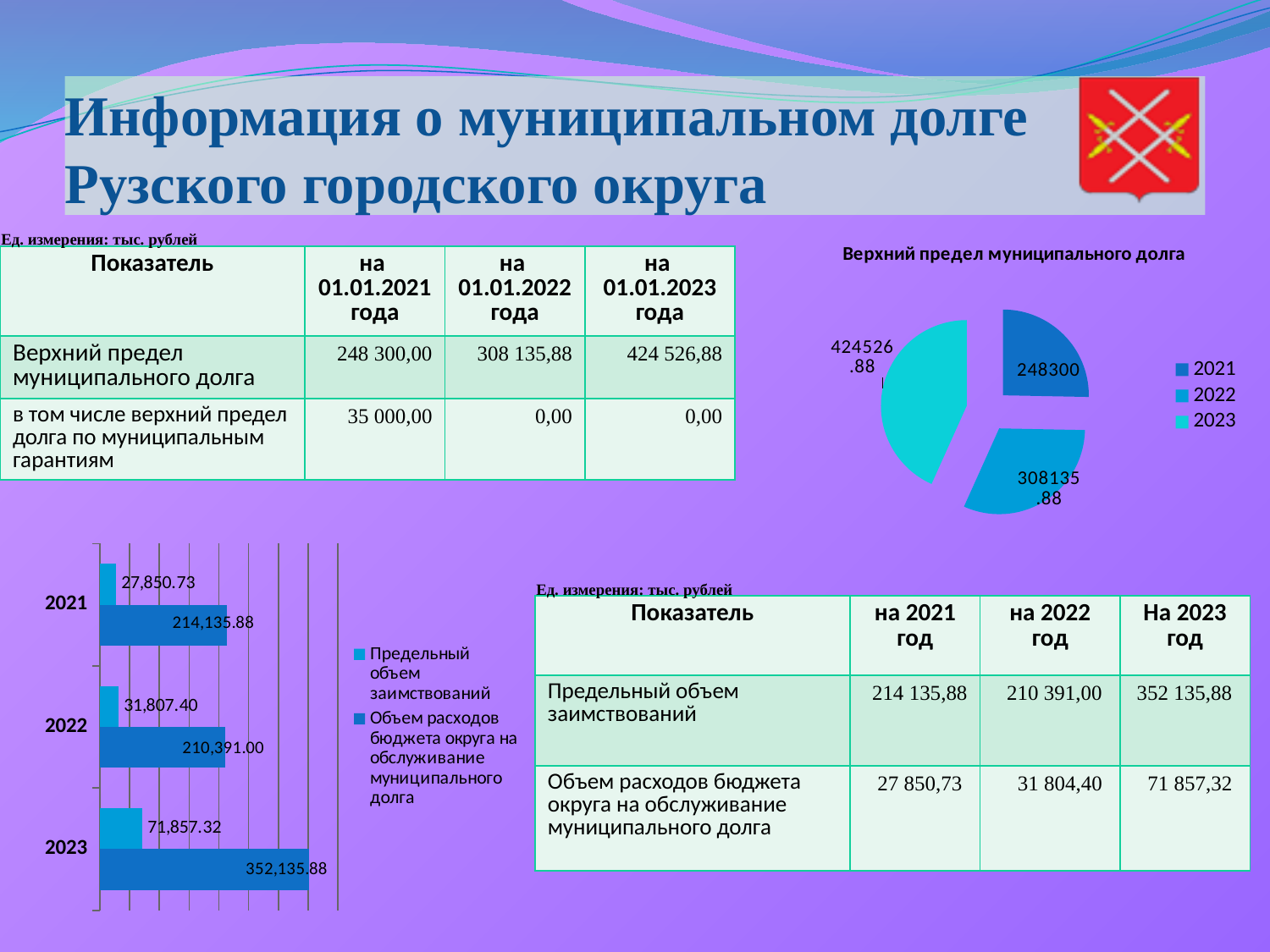
In the bar chart at the bottom left, what is the value of the shorter bar for 2021? 27,850.73 What kind of chart is the chart titled 'Верхний предел муниципального долга'? pie chart In the pie chart 'Верхний предел муниципального долга', how many years does the legend list? 3 In the pie chart 'Верхний предел муниципального долга', what is the value shown for 2023? 424526.88 In the bar chart at the bottom left, which year has the longest bar? 2023 In the bar chart at the bottom left, how many series does the legend list? 2 In the pie chart 'Верхний предел муниципального долга', which year has the largest slice? 2023 In the pie chart 'Верхний предел муниципального долга', what is the value shown for 2021? 248300 In the pie chart 'Верхний предел муниципального долга', which year has the smallest slice? 2021 What kind of chart is the chart at the bottom left of the slide? bar chart In the bar chart at the bottom left, how many year categories are shown? 3 In the bar chart at the bottom left, what is the value of the longer bar for 2023? 352,135.88